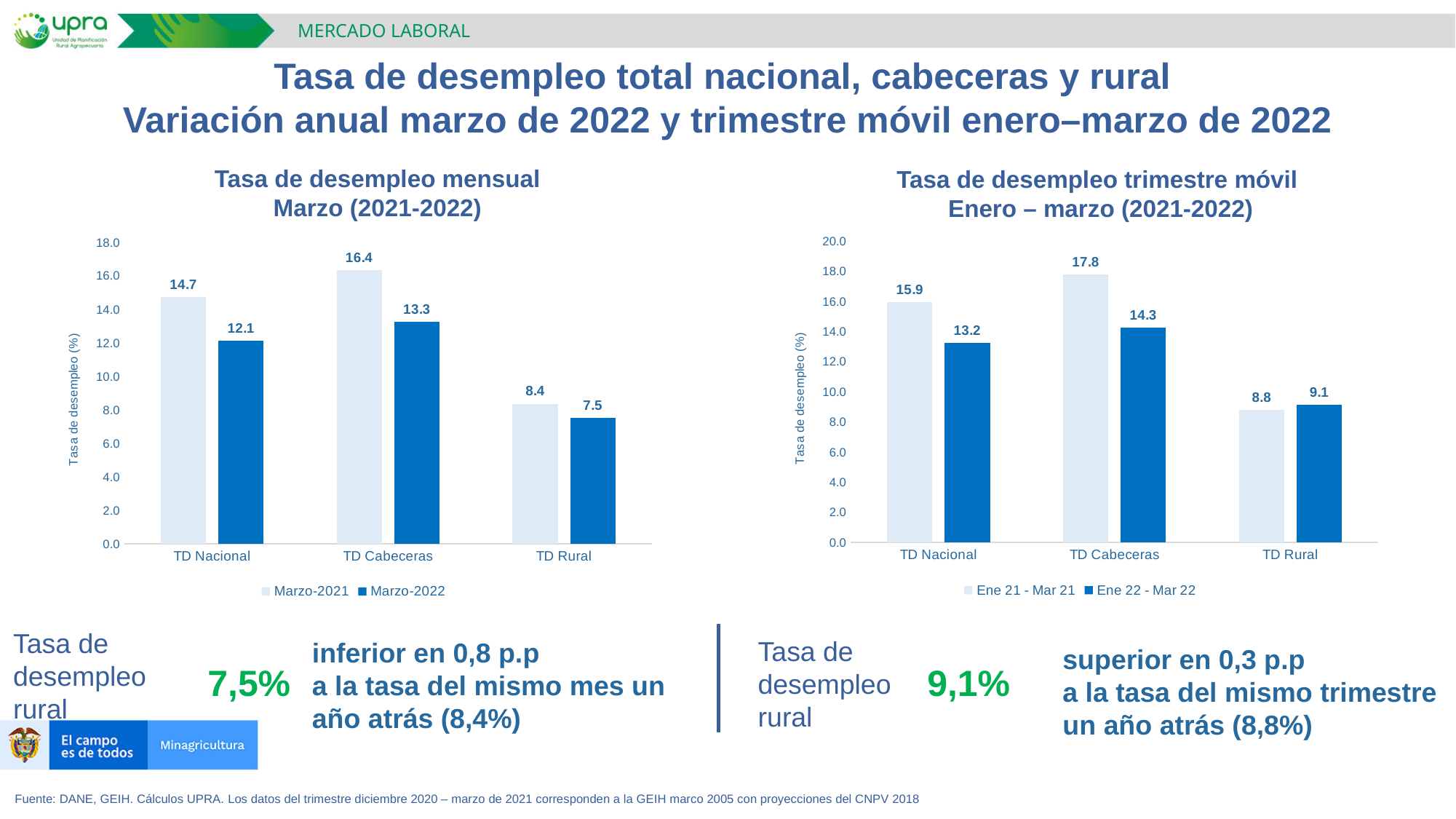
In the 'Tasa de desempleo trimestre móvil Enero – marzo (2021-2022)' chart, what is the value for TD Rural in Ene 21 - Mar 21? 8.8 In the 'Tasa de desempleo mensual Marzo (2021-2022)' chart, which category has the lowest Marzo-2022 value? TD Rural How many categories are shown on the x axis of the 'Tasa de desempleo trimestre móvil Enero – marzo (2021-2022)' chart? 3 In the 'Tasa de desempleo trimestre móvil Enero – marzo (2021-2022)' chart, what is the difference between the Ene 21 - Mar 21 and Ene 22 - Mar 22 values for TD Nacional? 2.7 In the 'Tasa de desempleo trimestre móvil Enero – marzo (2021-2022)' chart, which category has the highest Ene 21 - Mar 21 value? TD Cabeceras In the 'Tasa de desempleo trimestre móvil Enero – marzo (2021-2022)' chart, what is the value for TD Cabeceras in Ene 22 - Mar 22? 14.3 In the 'Tasa de desempleo trimestre móvil Enero – marzo (2021-2022)' chart, which is larger for TD Rural: Ene 21 - Mar 21 or Ene 22 - Mar 22? Ene 22 - Mar 22 In the 'Tasa de desempleo mensual Marzo (2021-2022)' chart, what is the difference between the Marzo-2021 and Marzo-2022 values for TD Rural? 0.9 In the 'Tasa de desempleo mensual Marzo (2021-2022)' chart, what is the value for TD Nacional in Marzo-2022? 12.1 What type of chart is the 'Tasa de desempleo mensual Marzo (2021-2022)' chart? Bar chart In the 'Tasa de desempleo mensual Marzo (2021-2022)' chart, how many series does the legend list? 2 In the 'Tasa de desempleo mensual Marzo (2021-2022)' chart, what is the value for TD Cabeceras in Marzo-2021? 16.4